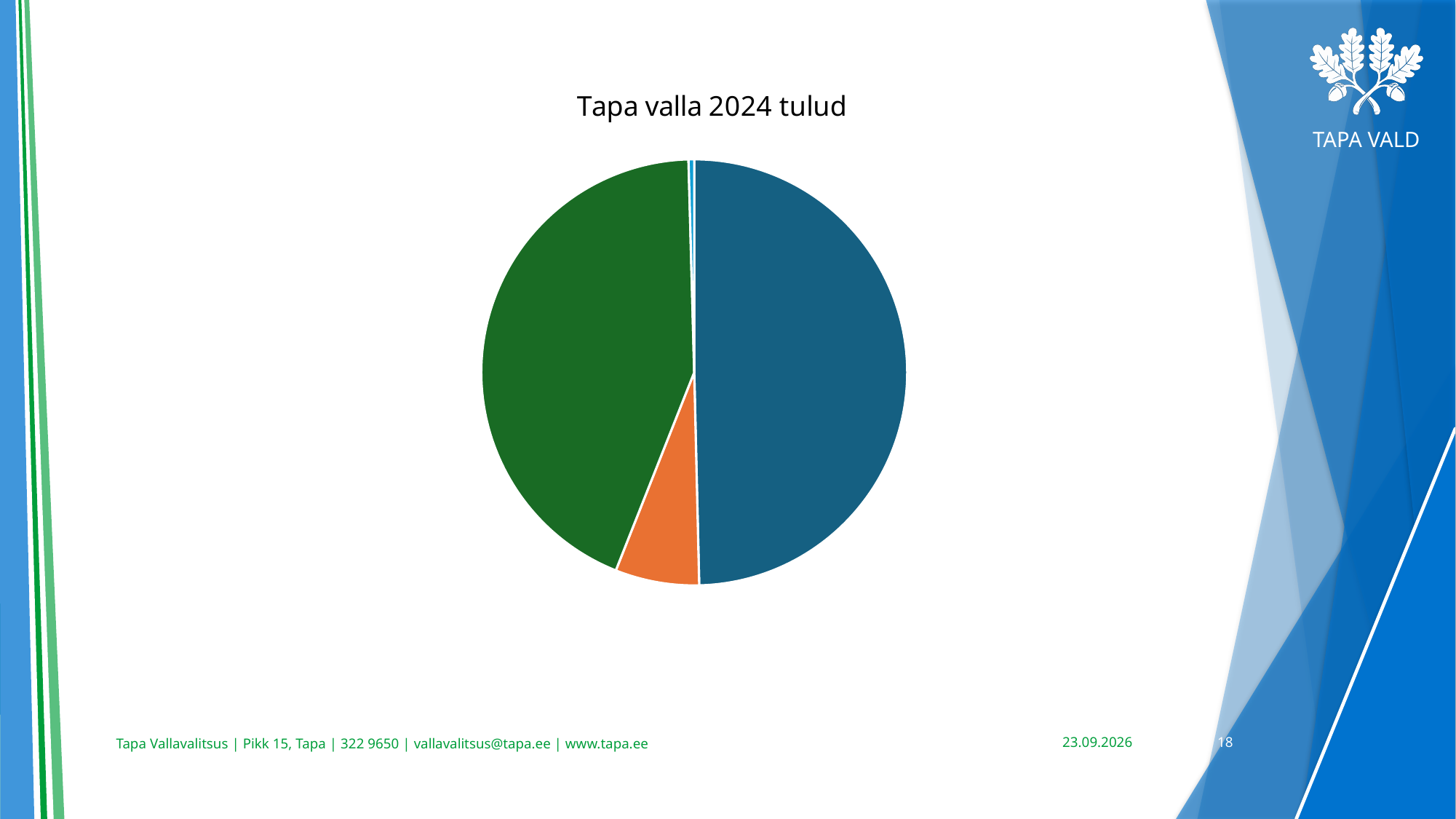
Which slice is larger, the orange one or the dark green one? dark green How many slices does the pie chart have? 4 What kind of chart is shown on the slide? pie chart What is the title of the chart? Tapa valla 2024 tulud Which colour is the smallest slice of the pie chart? light blue Which colour is the largest slice of the pie chart? dark blue